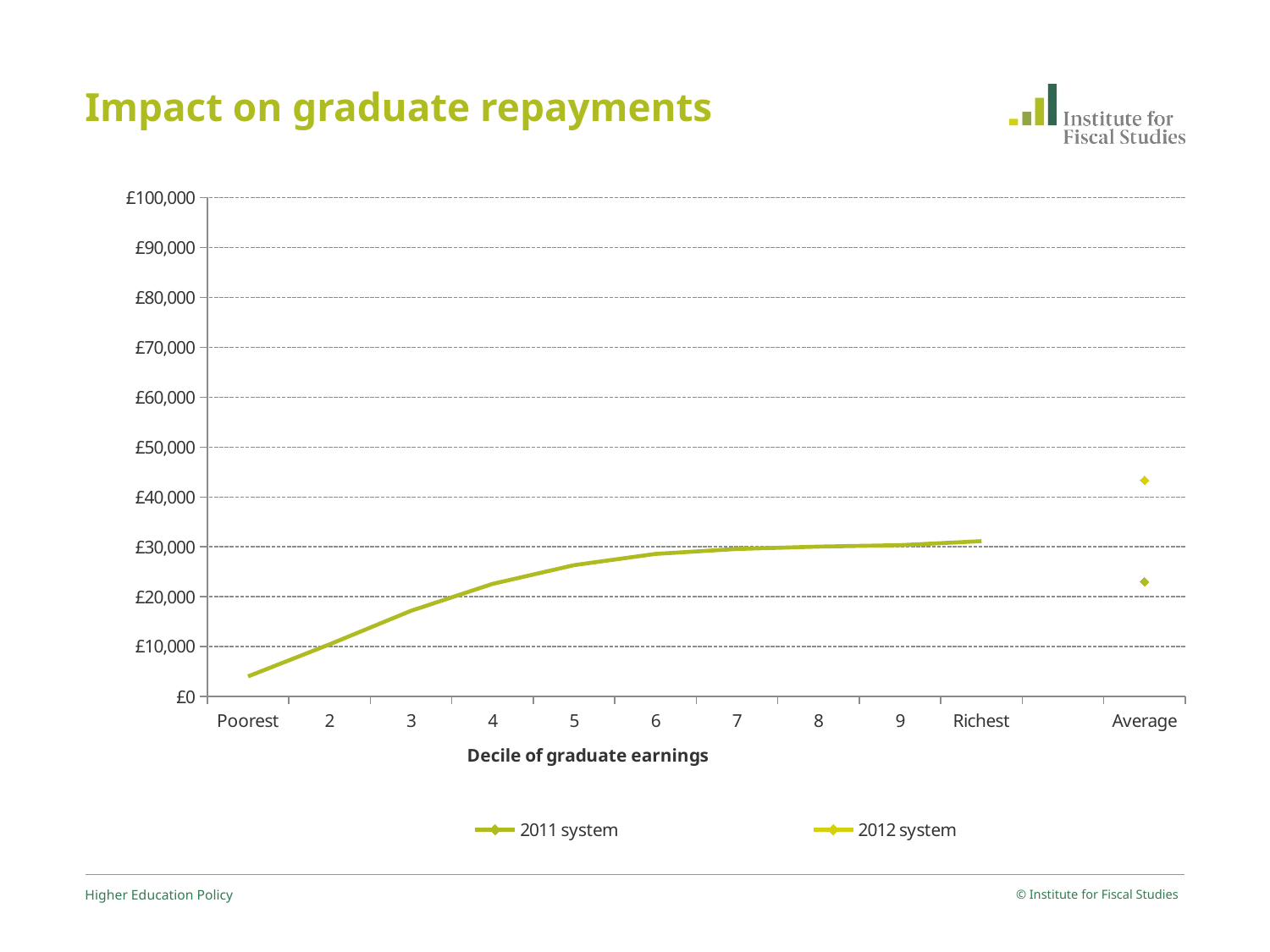
Is the value for the 2011 system at decile 5 greater or less than £20,000? greater Is the value for the 2012 system at Average greater or less than £40,000? greater Does the 2011 system line rise or fall from Poorest to Richest? rises How many categories are shown on the x axis? 11 Is the value for the 2011 system at decile 3 greater or less than £20,000? less What is the title of the chart? Impact on graduate repayments What is the title of the x axis? Decile of graduate earnings What kind of chart is shown on the slide? line chart How many series does the legend list? 2 Which is larger for the 2011 system, the value at Richest or the value at Poorest? Richest